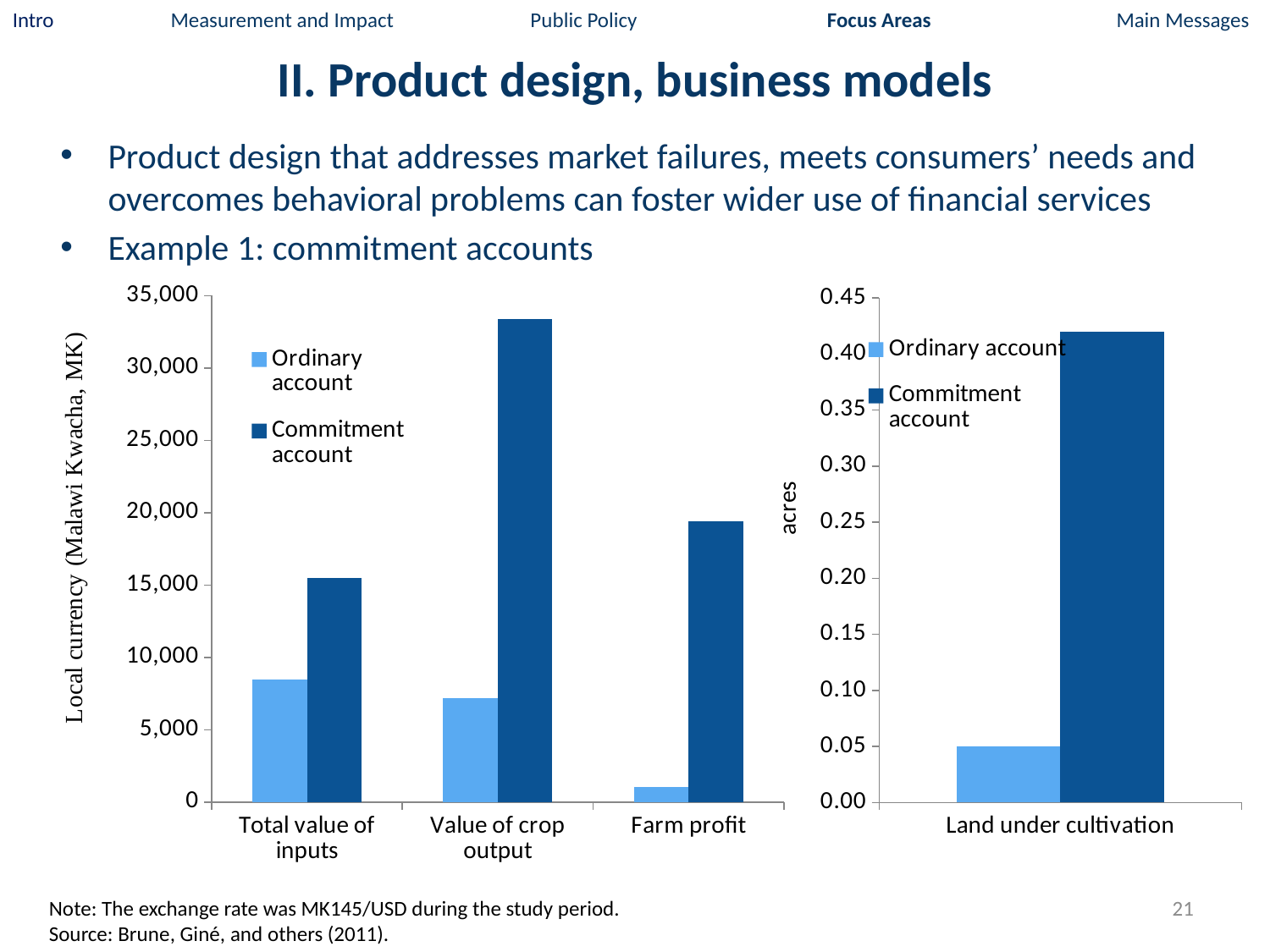
In the left chart, which category has the lowest Ordinary account bar? Farm profit What is the y-axis label of the right chart? acres In the left chart, is the Ordinary account value for Total value of inputs greater or less than 10,000? less How many categories are shown on the x axis of the left chart? 3 In the left chart, which is larger for the Commitment account: Total value of inputs or Farm profit? Farm profit What kind of chart is the left chart on the slide? bar chart In the right chart, is the Commitment account value for Land under cultivation greater or less than 0.40? greater In the left chart, which category has the highest Commitment account bar? Value of crop output In the left chart, is the Commitment account value for Value of crop output greater or less than 30,000? greater How many series does the legend of the left chart list? 2